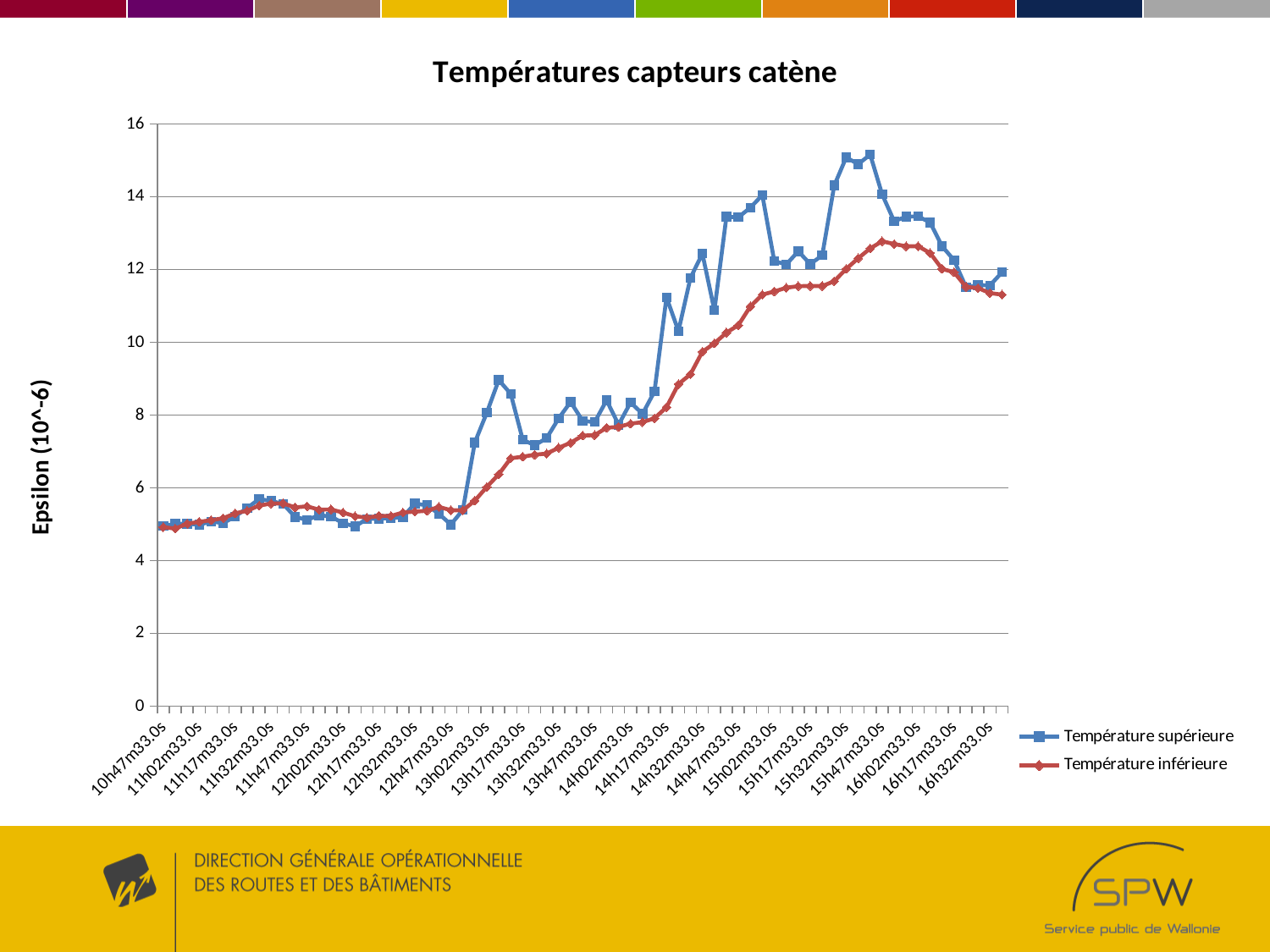
Is the value of Température inférieure at 15h47m33.0s greater or less than 12? greater What is the label of the vertical axis? Epsilon (10^-6) What kind of chart is shown on the slide? line chart Is the value of Température inférieure at 15h02m33.0s greater or less than 12? less What is the title of the chart? Températures capteurs catène How many series does the legend list? 2 Is the value of Température supérieure at 10h47m33.0s greater or less than 6? less Overall, do the values of Température supérieure rise or fall from left to right along the x axis? rise Which series has the higher value at 15h47m33.0s, Température supérieure or Température inférieure? Température supérieure